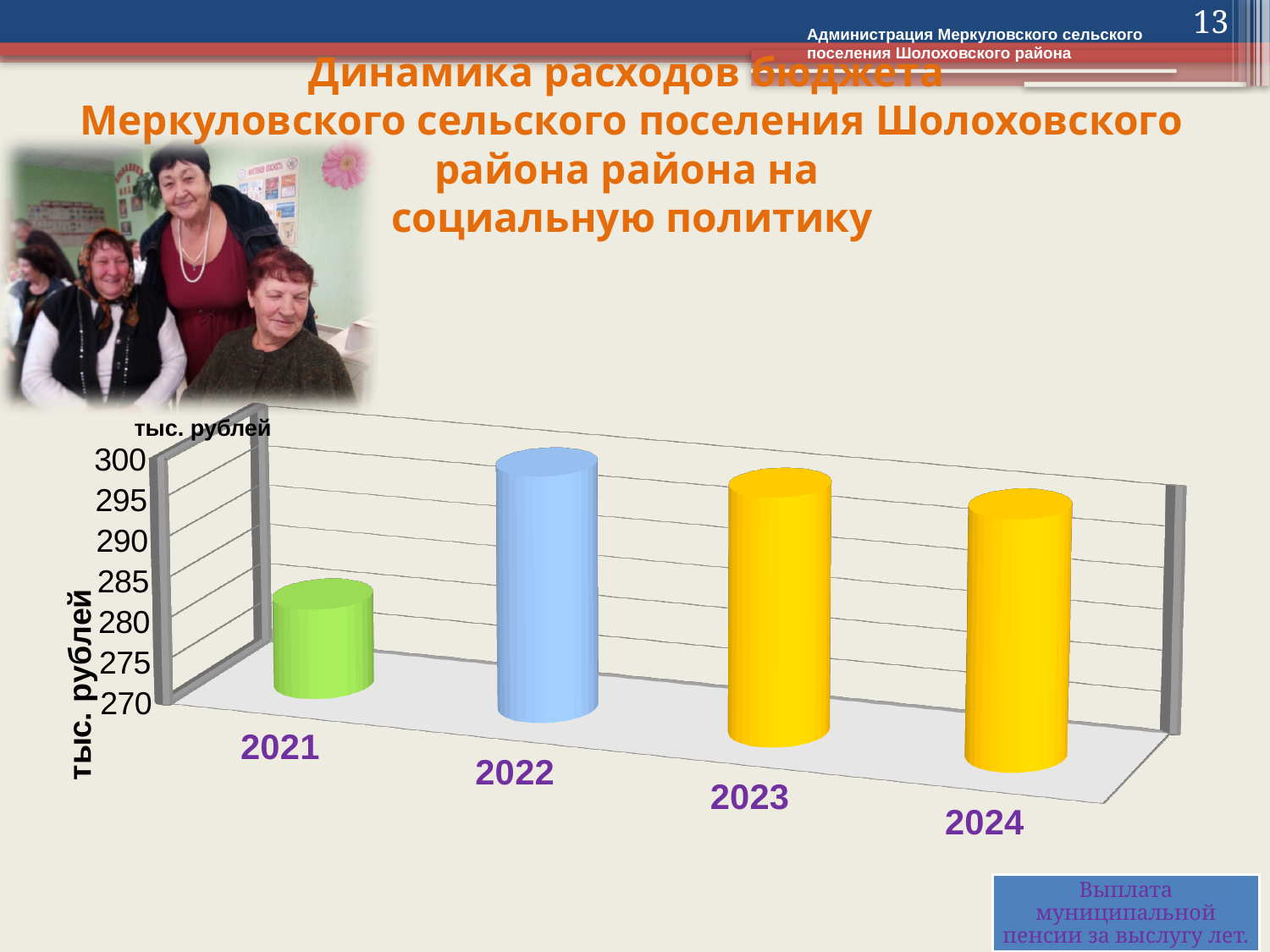
Is the value for 2021 greater or less than 275? greater Is the value for 2022 greater or less than 290? greater Which is larger, the value for 2021 or the value for 2022? 2022 What kind of chart is shown on the slide? bar chart Is the value for 2023 greater or less than 290? greater How many years (categories) are plotted on the chart? 4 What unit is shown on the vertical axis of the chart? тыс. рублей Which is larger, the value for 2024 or the value for 2021? 2024 Which year has the lowest value on the chart? 2021